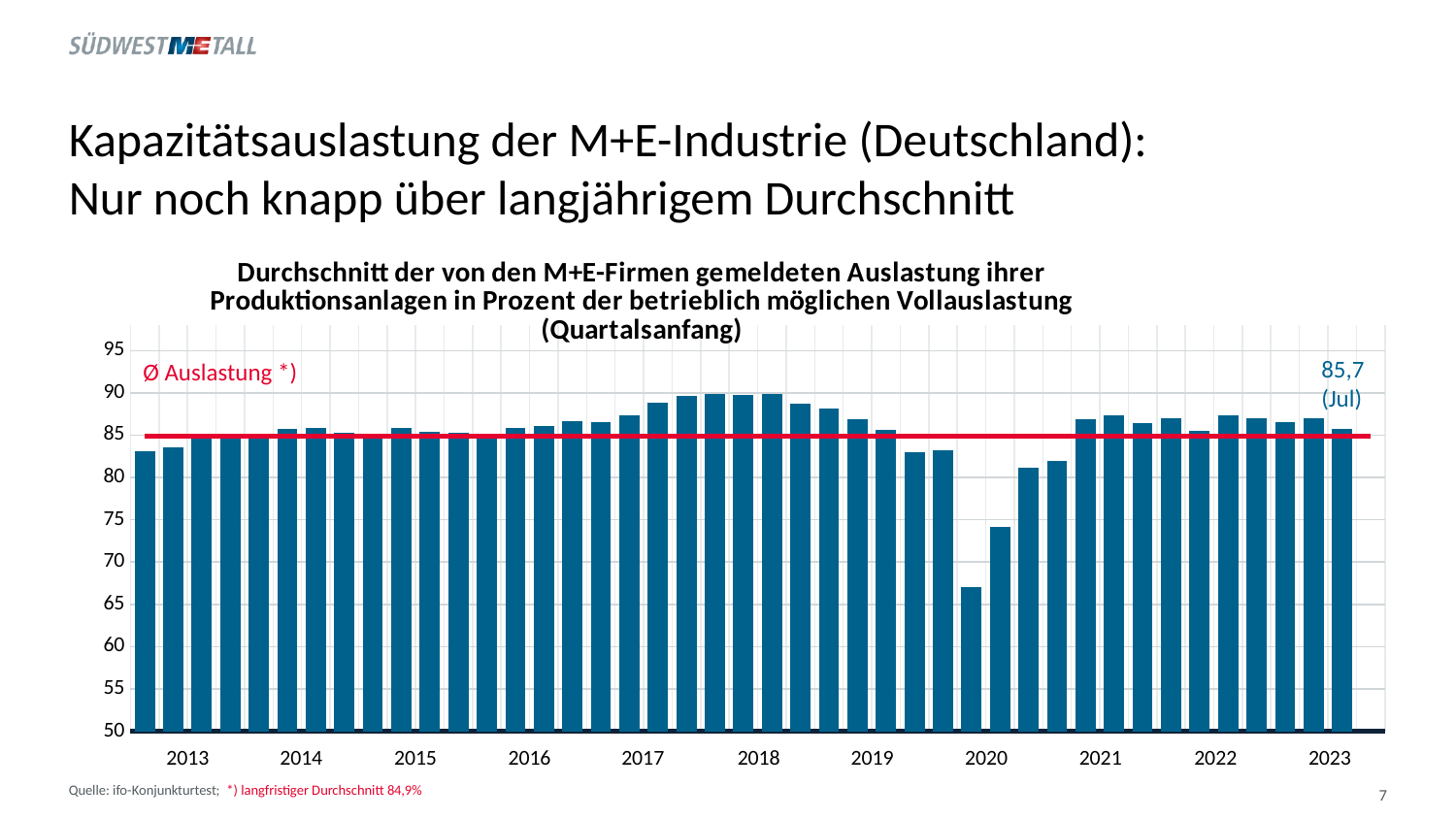
Do the values rise or fall from mid-2020 to the start of 2021? rise Is the July 2023 value (85,7) above or below the long-term average line (84,9%)? above Is the lowest bar in 2020 greater or less than 70? less In which year does the lowest bar of the chart occur? 2020 Do the values rise or fall from 2019 into the first half of 2020? fall How many year labels are shown on the x axis? 11 What kind of chart is shown on the slide? bar chart Is the value for the first bar of 2013 greater or less than 85? less Is the value for the first bar of 2021 greater or less than 85? less What is the long-term average utilization (langfristiger Durchschnitt) given in the footnote? 84,9% What is the capacity utilization value printed for July 2023 (the last bar)? 85,7 What does the red horizontal line in the chart represent? Ø Auslastung (langfristiger Durchschnitt)